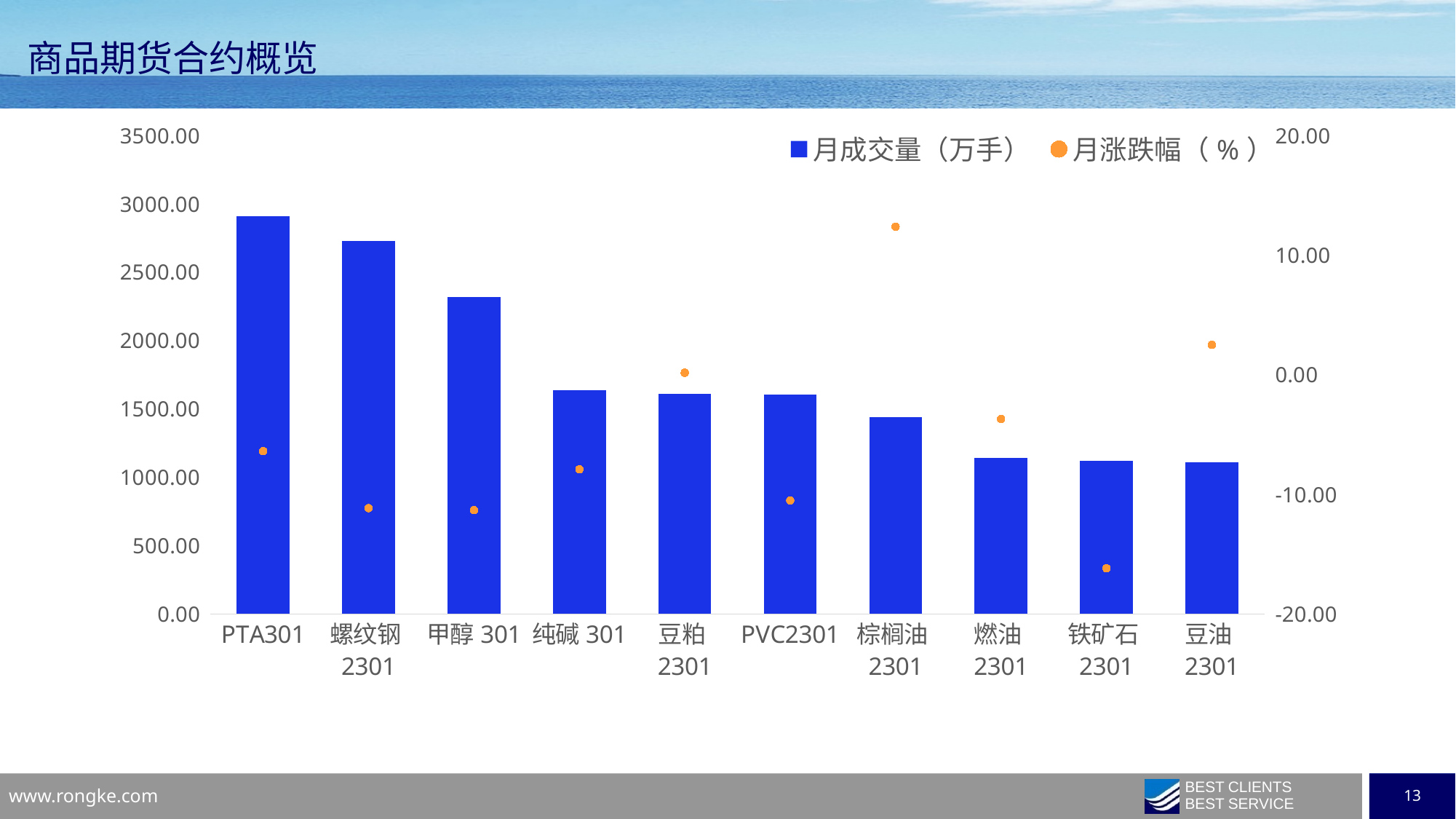
What colour are the 月成交量（万手） bars? blue Which category has the lowest 月涨跌幅（%） point? 铁矿石2301 Which has the larger 月成交量（万手）, 螺纹钢2301 or 甲醇 301? 螺纹钢2301 Is the 月成交量（万手） value for PTA301 greater or less than 2500? greater How many categories are shown on the x axis? 10 Which category has the highest 月涨跌幅（%） point? 棕榈油2301 Is the 月涨跌幅（%） value for 棕榈油2301 greater or less than 10? greater Do the 月成交量（万手） bars rise or fall from left to right along the x axis? fall How many series does the legend list? 2 Which category has the highest 月成交量（万手） bar? PTA301 Is the 月成交量（万手） value for 燃油2301 greater or less than 1500? less